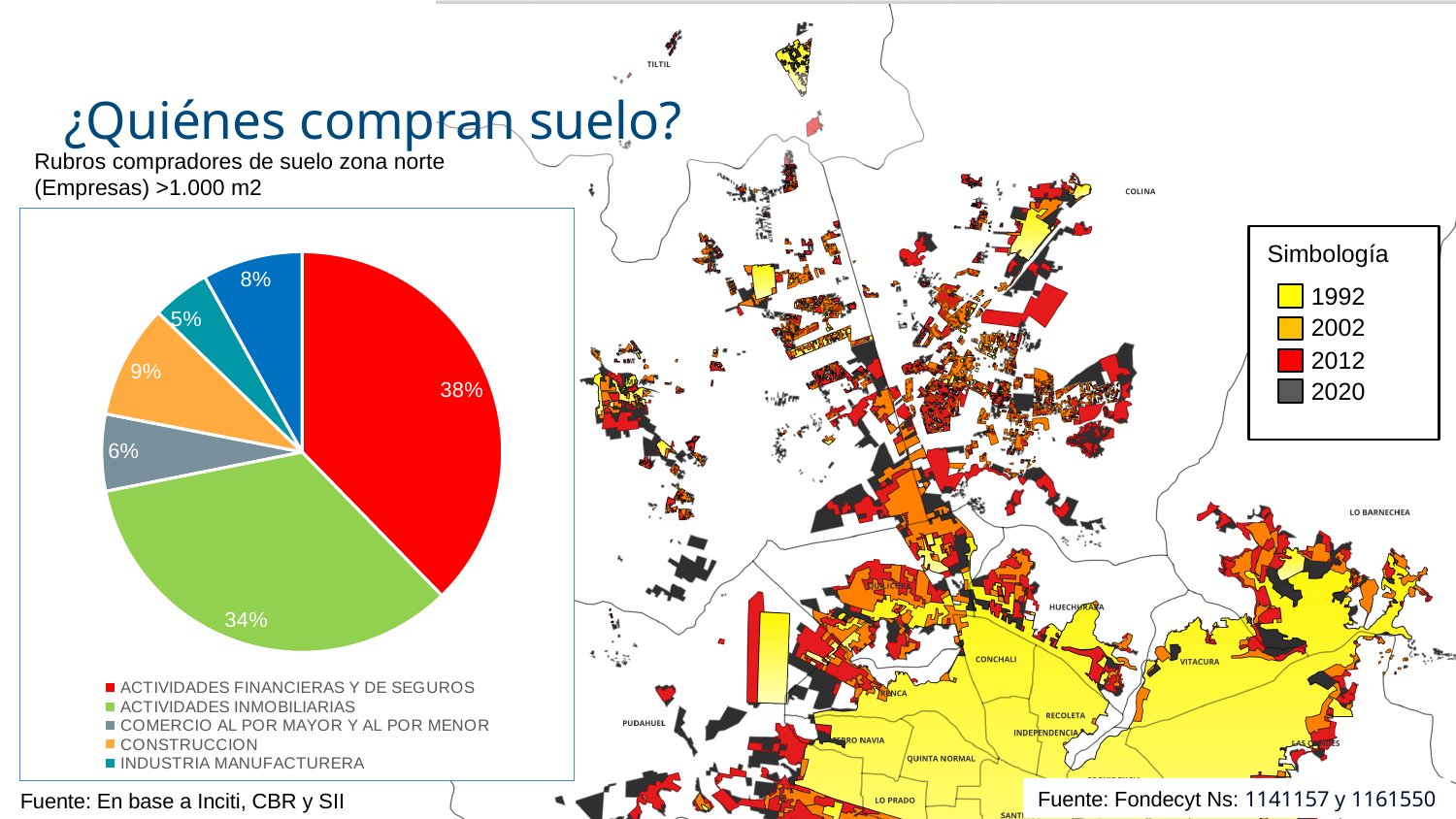
What is the subtitle printed above the pie chart? Rubros compradores de suelo zona norte (Empresas) >1.000 m2 Which category has the largest slice in the pie chart? ACTIVIDADES FINANCIERAS Y DE SEGUROS In the pie chart, what share is shown for COMERCIO AL POR MAYOR Y AL POR MENOR? 6% In the pie chart, which is larger: CONSTRUCCION or INDUSTRIA MANUFACTURERA? CONSTRUCCION In the pie chart, what share is shown for ACTIVIDADES FINANCIERAS Y DE SEGUROS? 38% In the pie chart, what share is shown for INDUSTRIA MANUFACTURERA? 5% What colour is the slice for ACTIVIDADES INMOBILIARIAS in the pie chart? green What kind of chart is shown on the left of the slide? pie chart In the pie chart, what share is shown for ACTIVIDADES INMOBILIARIAS? 34% In the pie chart, what share is shown for CONSTRUCCION? 9% What is the difference in percentage points between ACTIVIDADES FINANCIERAS Y DE SEGUROS and ACTIVIDADES INMOBILIARIAS in the pie chart? 4 How many slices does the pie chart have? 6